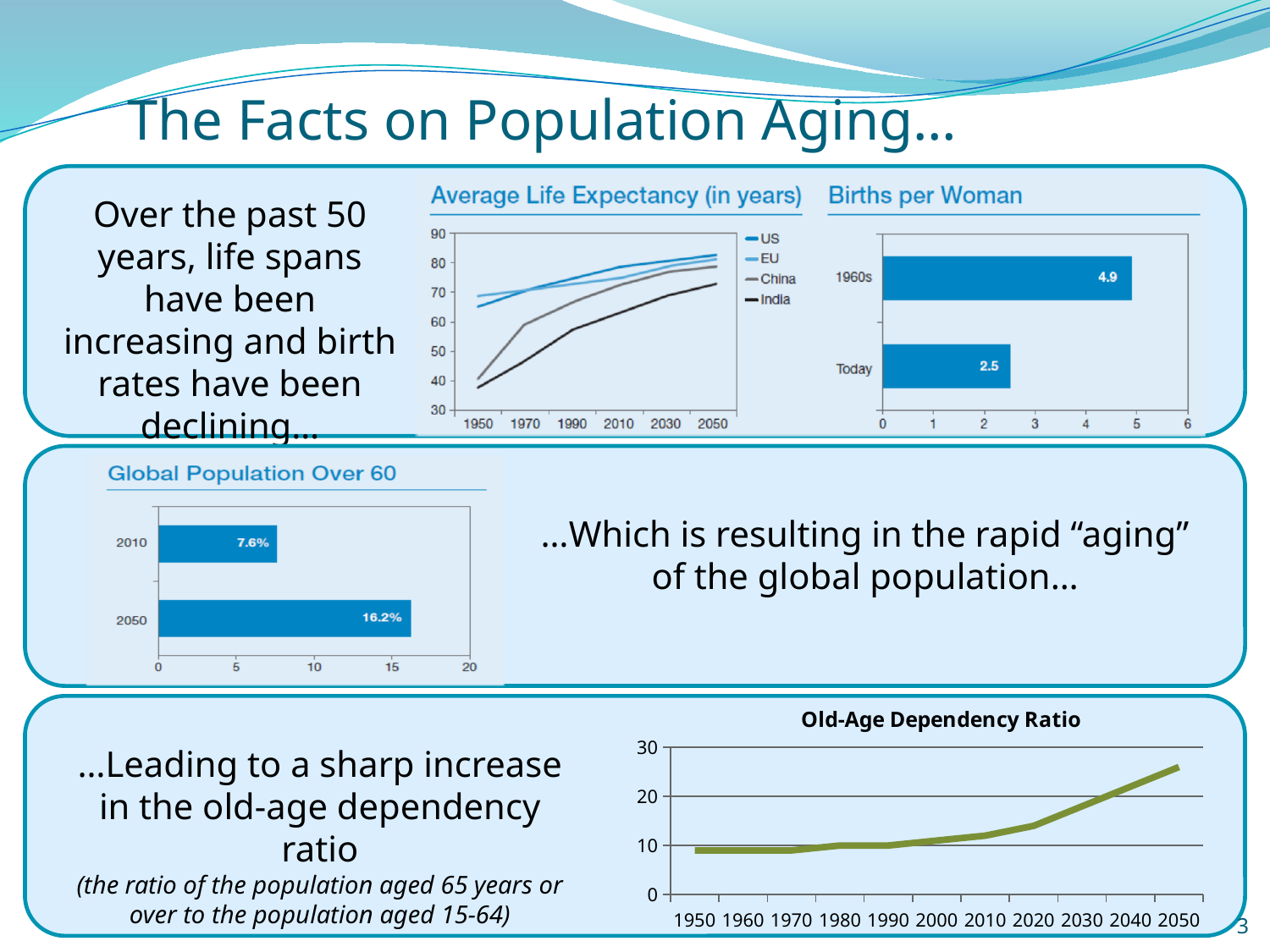
In the "Births per Woman" chart, what is the value for Today? 2.5 In the "Average Life Expectancy (in years)" chart, which series has the lowest value in 1950? India How many series does the legend of the "Average Life Expectancy (in years)" chart list? 4 In the "Old-Age Dependency Ratio" chart, do the values rise or fall from 1950 to 2050? Rise In the "Global Population Over 60" chart, what is the value for 2050? 16.2% In the "Global Population Over 60" chart, what is the difference between the 2050 value and the 2010 value? 8.6% In the "Old-Age Dependency Ratio" chart, is the value for 2050 greater or less than 20? greater What kind of chart is the "Average Life Expectancy (in years)" chart? Line chart In the "Global Population Over 60" chart, which year has the higher value, 2010 or 2050? 2050 In the "Births per Woman" chart, what is the difference between the 1960s value and the Today value? 2.4 In the "Births per Woman" chart, what is the value for the 1960s? 4.9 In the "Global Population Over 60" chart, what is the value for 2010? 7.6%